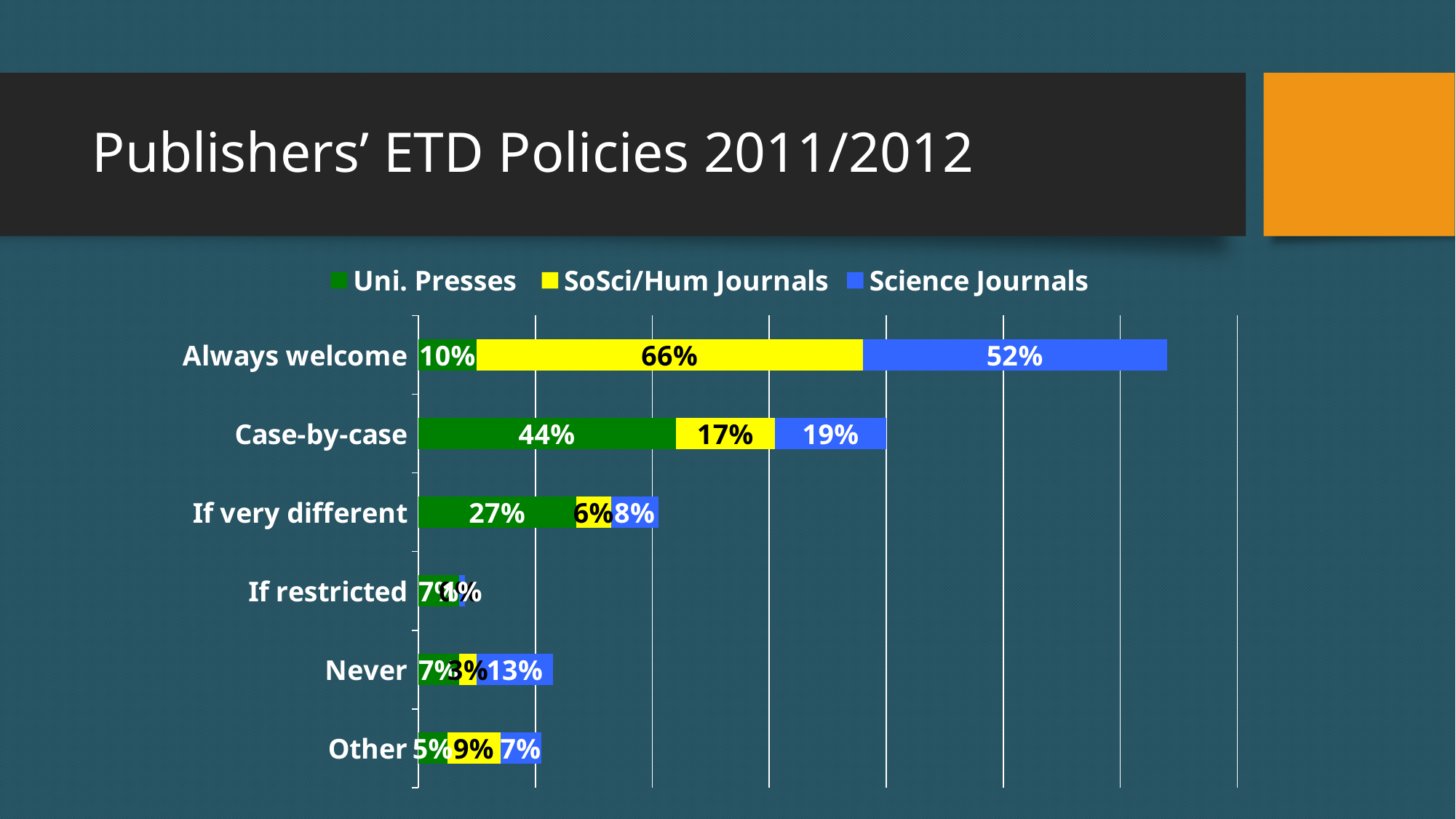
What is the value for SoSci/Hum Journals in the 'Other' category? 9% Which category has the highest value for Uni. Presses? Case-by-case What is the total of the stacked bar for 'Case-by-case'? 80% How many series does the legend list? 3 Which category has the highest value for Science Journals? Always welcome What is the value for Uni. Presses in the 'Case-by-case' category? 44% What is the difference between the Science Journals and Uni. Presses values in the 'Always welcome' category? 42% What is the value for Science Journals in the 'Never' category? 13% What type of chart is shown on the slide? Stacked bar chart What is the value for SoSci/Hum Journals in the 'Always welcome' category? 66% How many policy categories are shown on the chart? 6 Which is larger in the 'If very different' category: Uni. Presses or Science Journals? Uni. Presses